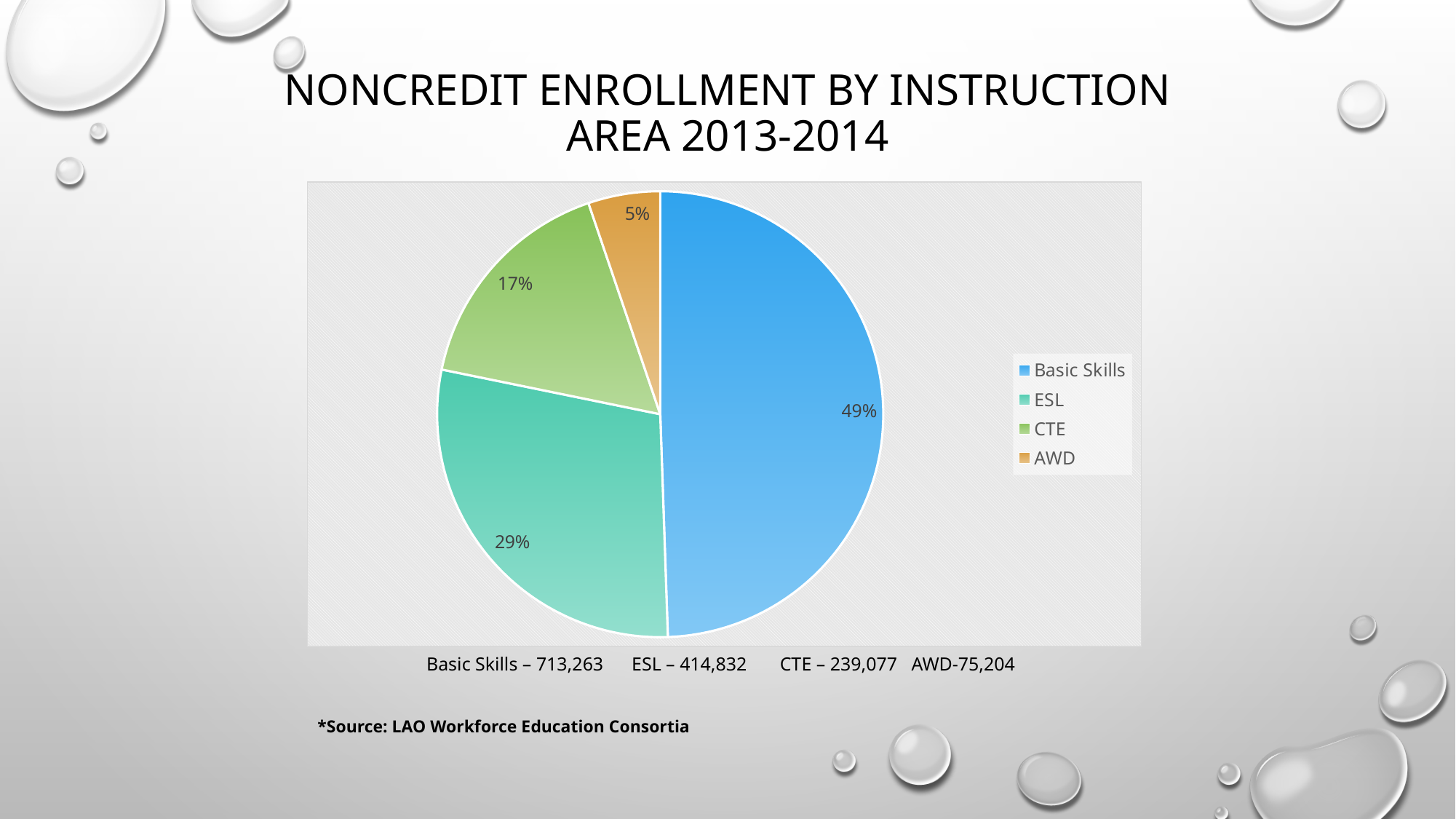
Which instruction area has the smallest share of noncredit enrollment? AWD How many categories does the pie chart show? 4 What is the title of the chart? Noncredit Enrollment by Instruction Area 2013-2014 What type of chart is shown on the slide? pie chart What percentage share does ESL have in the pie chart? 29% What percentage share does AWD have in the pie chart? 5% What colour is the Basic Skills slice in the pie chart? blue Which has a larger share, CTE or ESL? ESL What is the difference in percentage points between the Basic Skills share and the ESL share? 20 Which instruction area has the largest share of noncredit enrollment? Basic Skills What percentage share does CTE have in the pie chart? 17%